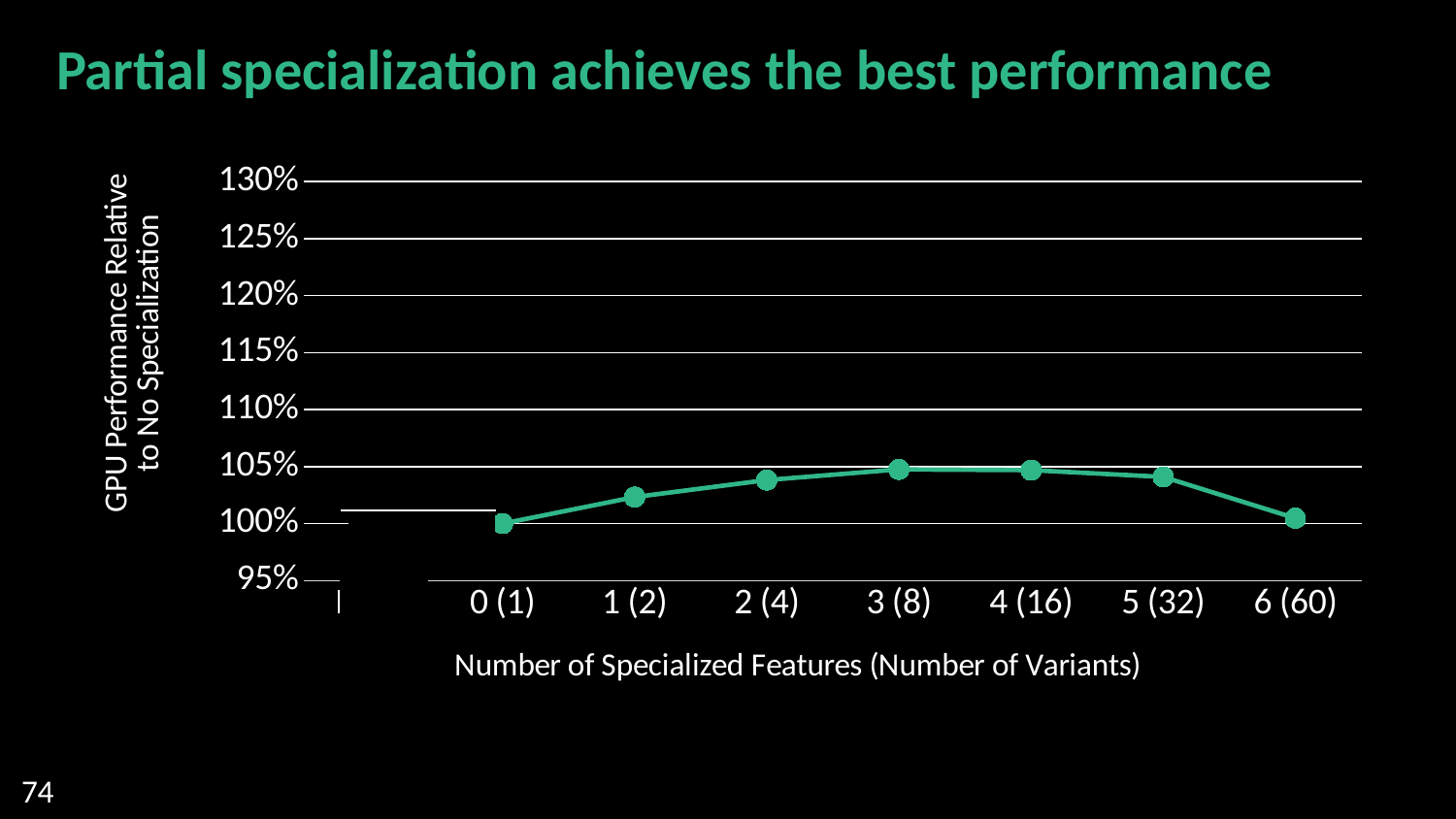
Is the value for 2 (4) greater or less than 105%? less What is the title of the chart on the slide? Partial specialization achieves the best performance Which has the larger value, 1 (2) or 5 (32)? 5 (32) Is the value for 6 (60) greater or less than 105%? less What kind of chart is shown on the slide? line chart How do the values change along the x axis from 0 (1) to 6 (60)? rise, then fall Is the value for 5 (32) greater or less than 110%? less Which has the larger value, 3 (8) or 6 (60)? 3 (8) Which has the larger value, 0 (1) or 2 (4)? 2 (4) What is the label of the x axis? Number of Specialized Features (Number of Variants) How many data points are plotted on the line? 7